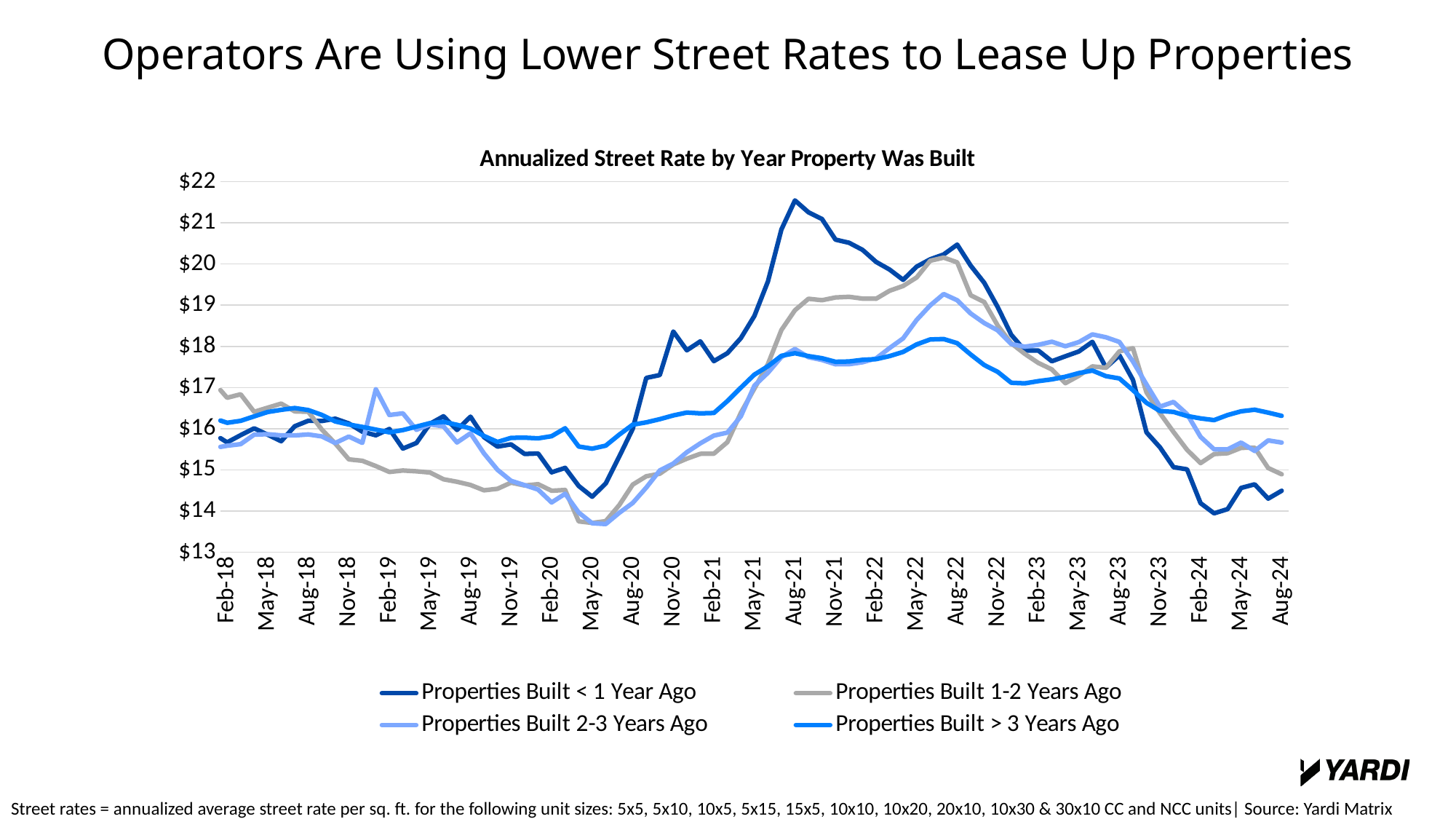
Is the value for Properties Built 2-3 Years Ago at Feb-19 greater or less than $16? greater Does the Properties Built < 1 Year Ago line rise or fall from Aug-21 to Feb-24? fall How many series does the legend list? 4 What is the title of the chart? Annualized Street Rate by Year Property Was Built What are the first and last labels on the x axis? Feb-18 and Aug-24 Is the value for Properties Built < 1 Year Ago at Aug-21 greater or less than $21? greater What kind of chart is shown on the slide? line chart At Aug-21, which is larger: Properties Built < 1 Year Ago or Properties Built > 3 Years Ago? Properties Built < 1 Year Ago Which series reaches the highest value anywhere on the chart? Properties Built < 1 Year Ago Is the value for Properties Built < 1 Year Ago at Feb-24 greater or less than $15? less At Aug-24, which is larger: Properties Built > 3 Years Ago or Properties Built < 1 Year Ago? Properties Built > 3 Years Ago